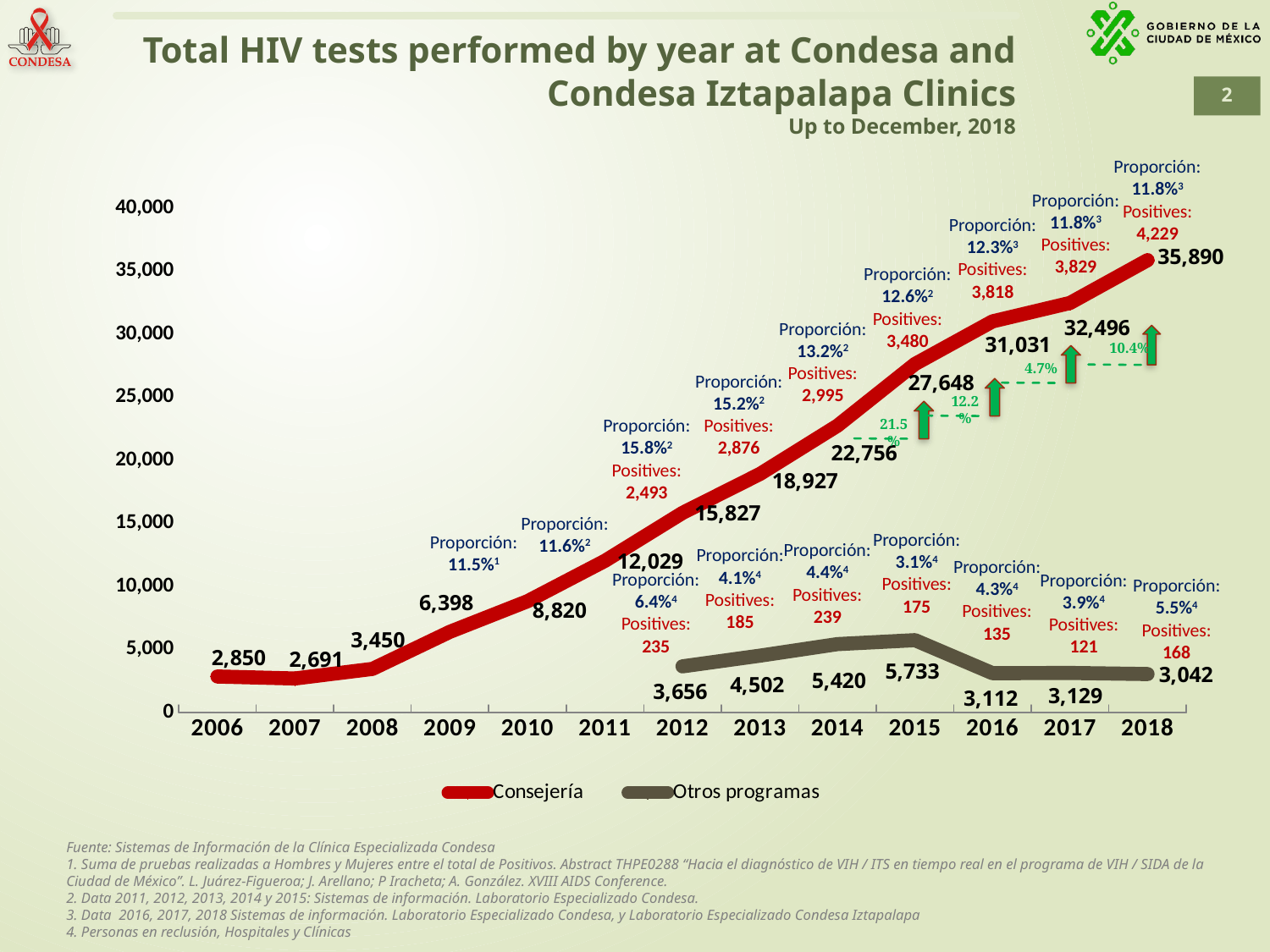
Is the Consejería value for 2015 greater or less than 25,000? greater How many years are shown on the x axis? 13 What is the Otros programas value for 2015? 5,733 What type of chart is shown on the slide? Line chart Which is larger in 2016: the Consejería value or the Otros programas value? Consejería In which year is the Consejería series lowest? 2007 In which year is the Otros programas series highest? 2015 Does the Consejería series generally rise or fall from 2008 to 2018? Rise What is the difference between the Consejería values for 2018 and 2017? 3,394 What is the Consejería value for 2011? 12,029 How many series does the legend list? 2 What is the Consejería value for 2018? 35,890